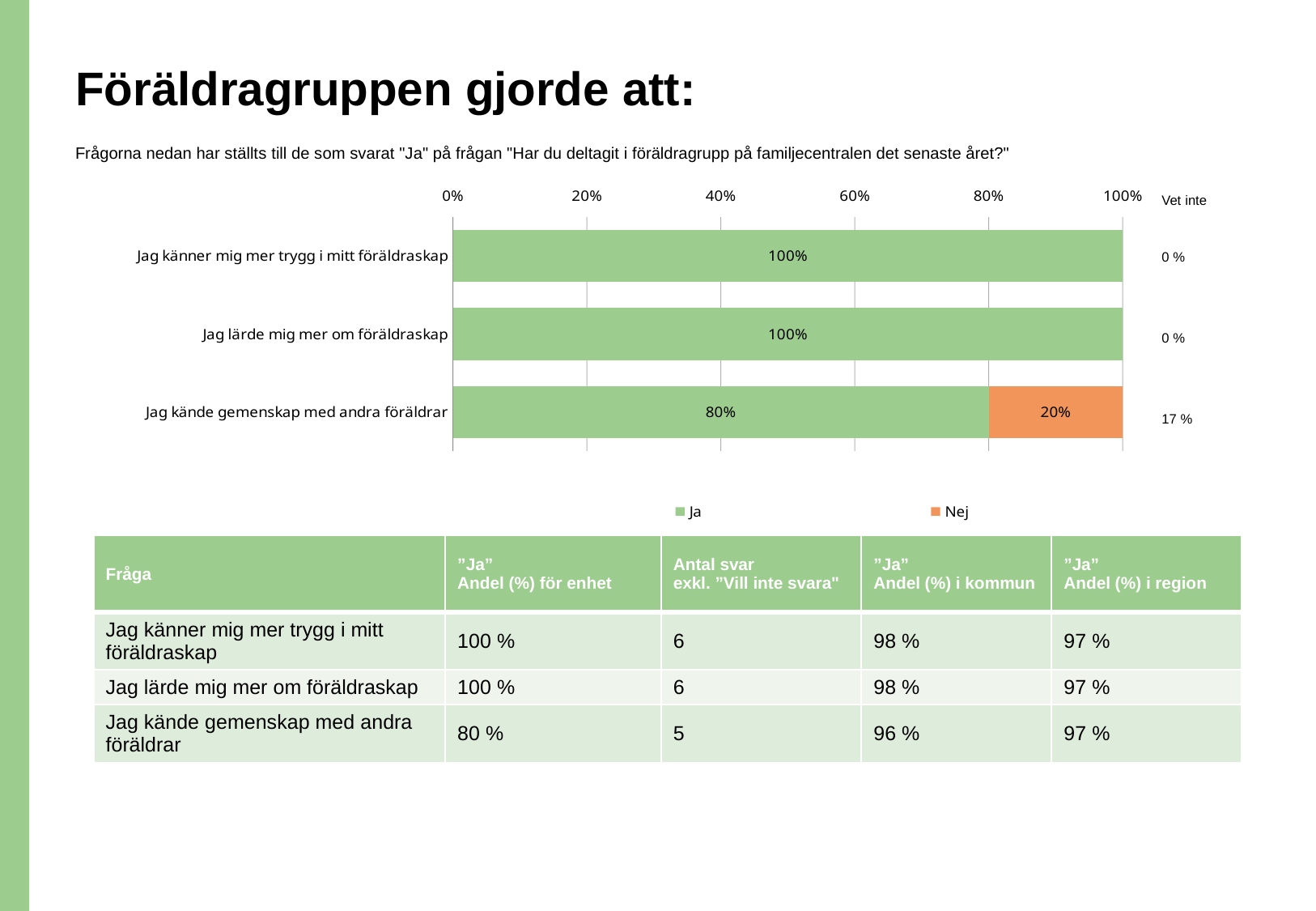
What is the "Ja" value for "Jag lärde mig mer om föräldraskap"? 100% What is the difference between the "Ja" and "Nej" values for "Jag kände gemenskap med andra föräldrar"? 60% What is the "Ja" value for "Jag kände gemenskap med andra föräldrar"? 80% What colour represents the "Nej" series in the chart? orange What is the total of the stacked bar for "Jag kände gemenskap med andra föräldrar"? 100% What is the "Ja" value for "Jag känner mig mer trygg i mitt föräldraskap"? 100% How many categories are shown in the chart? 3 Which category has the lowest "Ja" value? Jag kände gemenskap med andra föräldrar Is the "Ja" value for "Jag kände gemenskap med andra föräldrar" larger or smaller than its "Nej" value? larger How many series does the legend list? 2 What is the "Nej" value for "Jag kände gemenskap med andra föräldrar"? 20% What kind of chart is shown on the slide? bar chart